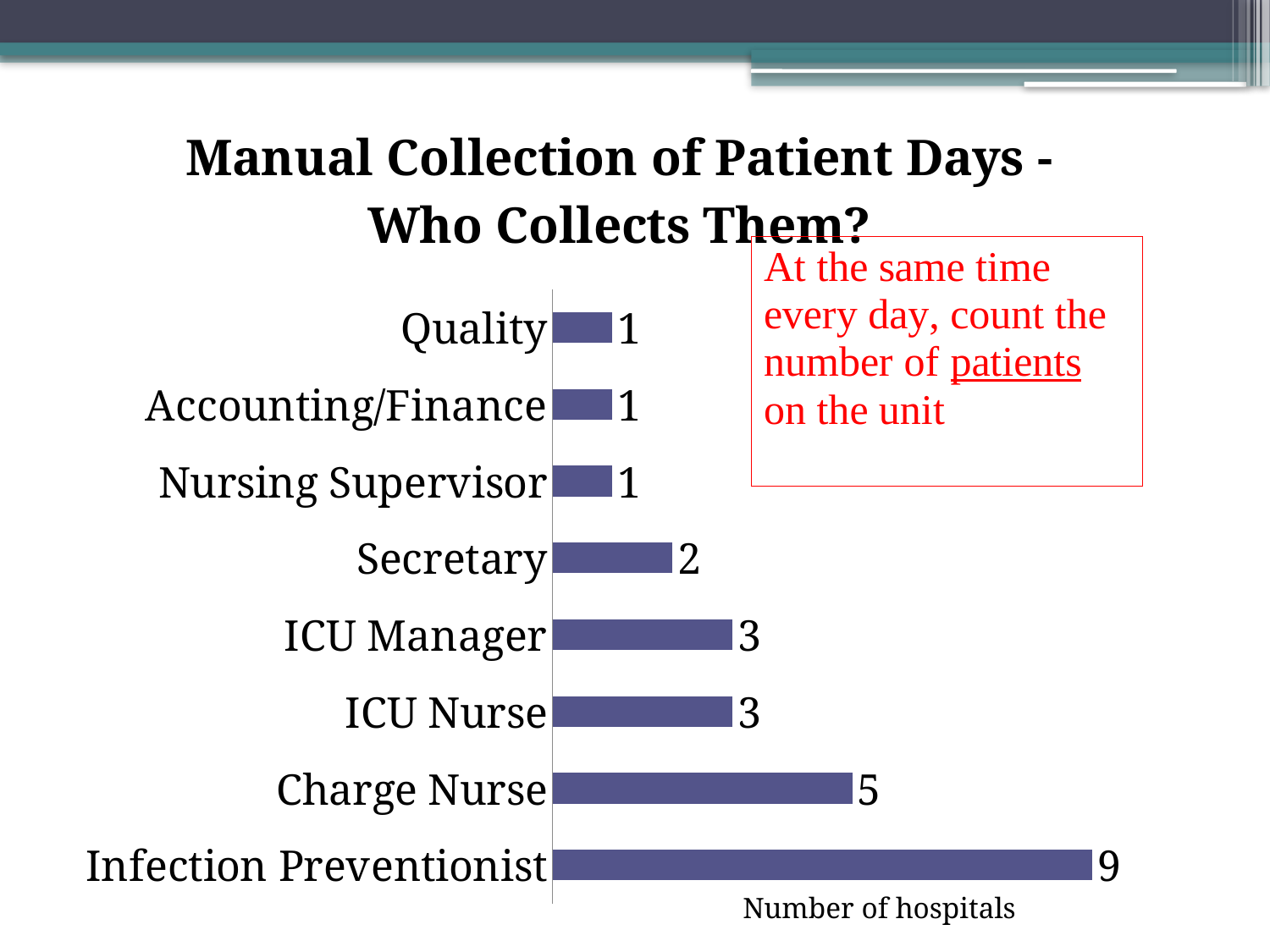
How many categories are shown in the chart? 8 How many hospitals have the Infection Preventionist collect patient days? 9 What is the label on the horizontal axis of the chart? Number of hospitals What is the value for Charge Nurse? 5 How many categories have a value of 1? 3 What is the difference between the values for Charge Nurse and Secretary? 3 What is the value for Secretary? 2 Which is larger, the value for ICU Nurse or the value for Secretary? ICU Nurse What is the value for ICU Manager? 3 What is the difference between the values for Infection Preventionist and Charge Nurse? 4 Which category has the highest number of hospitals? Infection Preventionist What kind of chart is shown on the slide? Bar chart